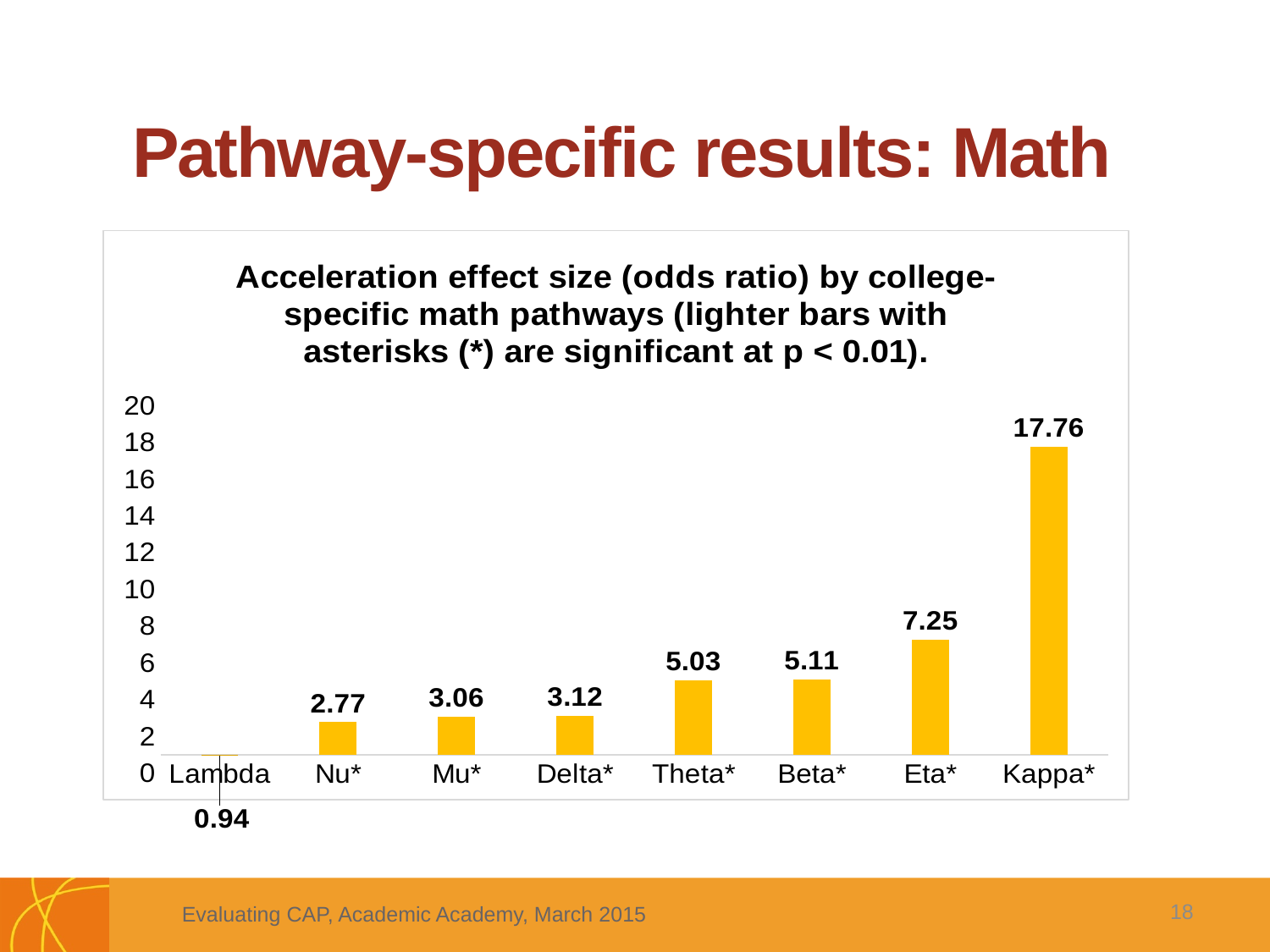
What is the difference between the values for Beta* and Nu*? 2.34 Which pathway has the highest value? Kappa* Do the values generally rise or fall from left to right along the x axis? Rise What is the value for Kappa*? 17.76 What is the difference between the values for Kappa* and Eta*? 10.51 What is the value for Lambda? 0.94 Which pathway has the lowest value? Lambda What is the value for Theta*? 5.03 What is the value for Eta*? 7.25 Which is larger, the value for Mu* or the value for Delta*? Delta* What kind of chart is this? Bar chart How many pathways are shown on the x axis? 8